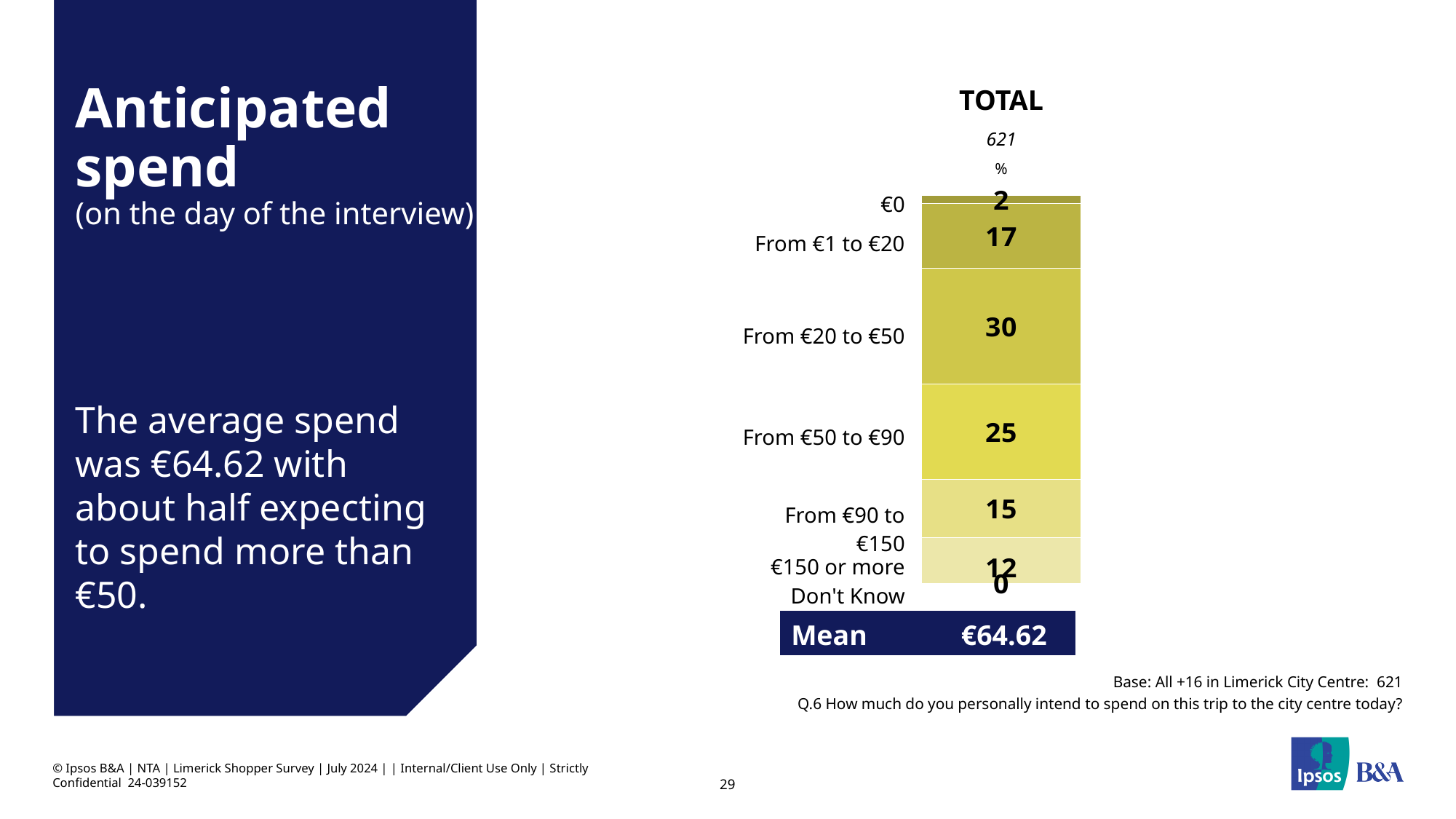
Which spend category has the lowest non-zero percentage? €0 Which spend category has the highest percentage? From €20 to €50 What is the base size shown above the TOTAL bar? 621 What is the difference in percentage points between 'From €20 to €50' and 'From €50 to €90'? 5 What percentage of respondents anticipated spending from €20 to €50? 30 What percentage of respondents anticipated spending €150 or more? 12 What is the mean anticipated spend shown below the chart? €64.62 Which is larger: the percentage for 'From €1 to €20' or for 'From €90 to €150'? From €1 to €20 How many spend categories are listed in the chart? 7 What percentage of respondents anticipated spending €0? 2 What is the value shown for 'Don't Know'? 0 What type of chart is shown on the slide? Stacked bar chart